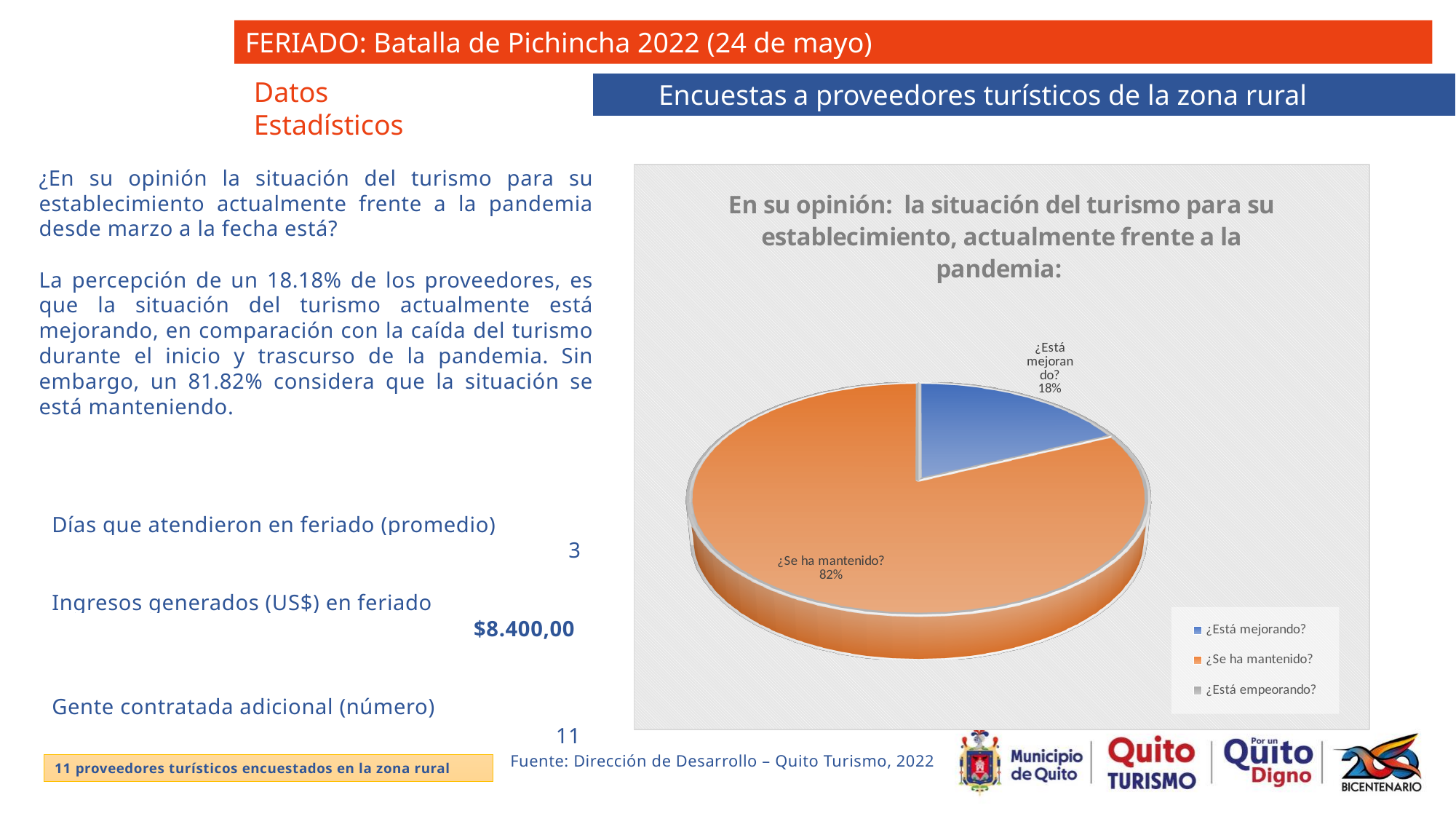
Which of the two labelled slices is larger: "¿Está mejorando?" or "¿Se ha mantenido?"? ¿Se ha mantenido? What percentage of the pie corresponds to "¿Está mejorando?"? 18% How many slices with data labels are visible in the pie chart? 2 Which category has the largest slice of the pie? ¿Se ha mantenido? What is the difference in percentage points between the "¿Se ha mantenido?" slice and the "¿Está mejorando?" slice? 64 Which legend entry has no visible slice in the pie chart? ¿Está empeorando? How many entries does the legend of the pie chart list? 3 What share of the pie does the "¿Está mejorando?" slice represent? 18% What percentage of the pie corresponds to "¿Se ha mantenido?"? 82% What kind of chart is shown on the slide? pie chart What colour is the "¿Se ha mantenido?" slice in the pie chart? orange